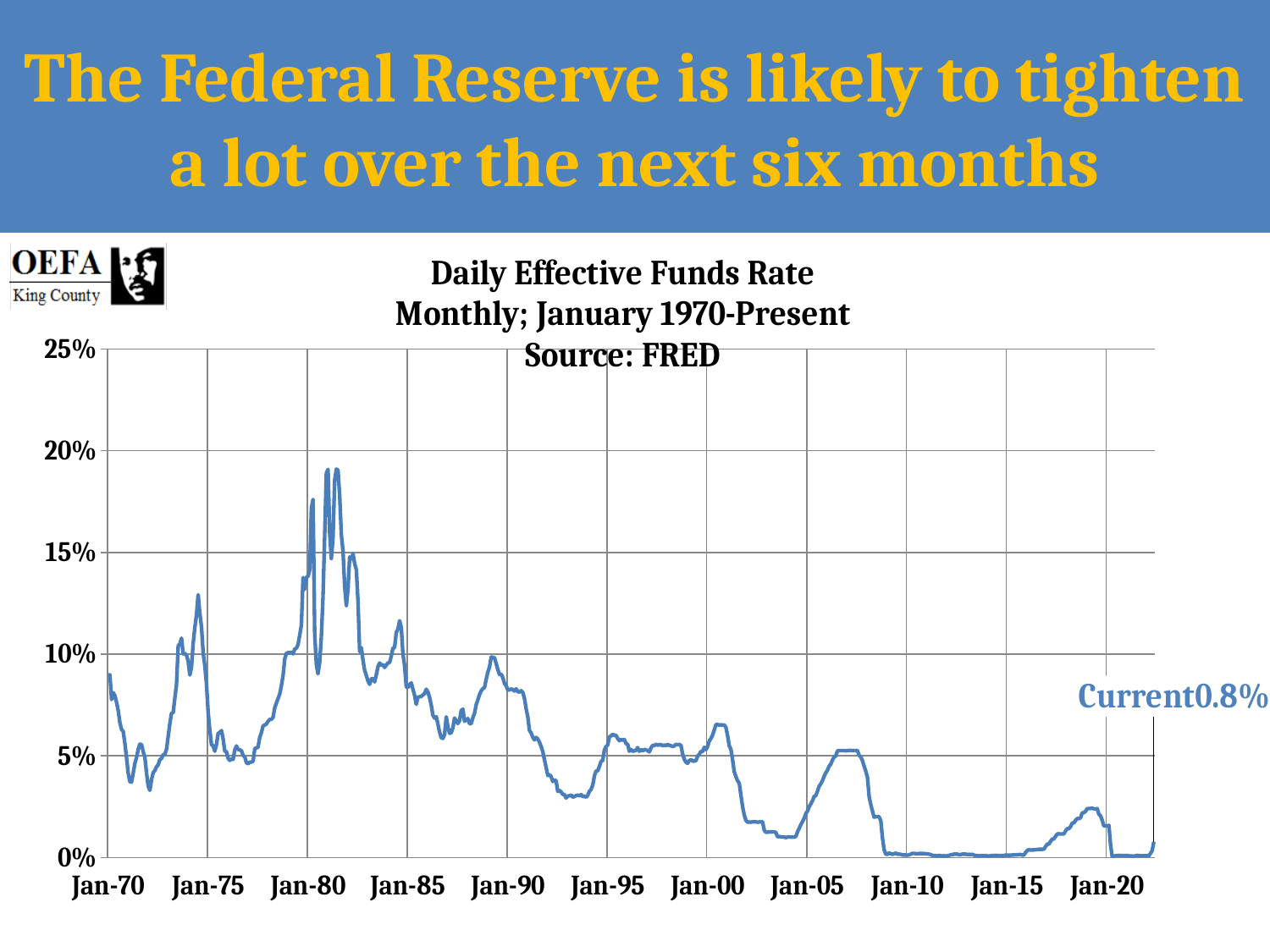
Is the value for Jan-10 greater or less than 5%? less What is the title of the chart? Daily Effective Funds Rate What kind of chart is shown on the slide? line chart How many year labels are shown on the x axis? 11 What source is cited for the chart's data? FRED Is the peak value of the funds rate around 1981 greater or less than 15%? greater Is the value for Jan-70 greater or less than 5%? greater What is the current value of the Daily Effective Funds Rate shown on the chart? 0.8% Does the funds rate generally rise or fall from its peak around 1981 to Jan-20? fall